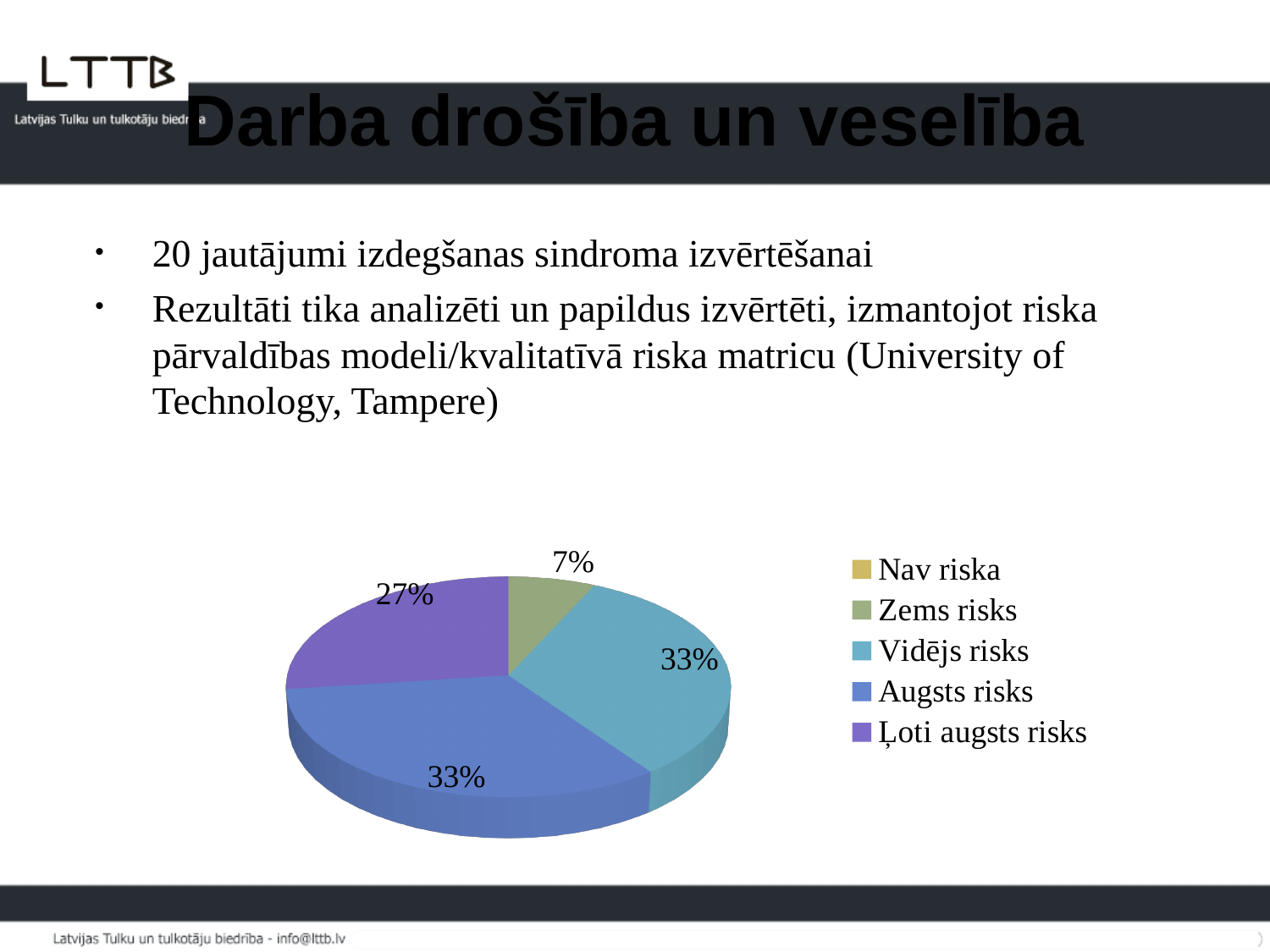
What is the difference in percentage points between the Augsts risks slice and the Ļoti augsts risks slice? 6% What kind of chart is shown on the slide? Pie chart Which slice is larger in the pie chart: Ļoti augsts risks or Zems risks? Ļoti augsts risks How many entries does the legend of the pie chart list? 5 What percentage does the pie chart show for Zems risks? 7% What percentage does the pie chart show for Ļoti augsts risks? 27% What percentage does the pie chart show for Vidējs risks? 33% What is the difference in percentage points between the Vidējs risks slice and the Zems risks slice? 26% How many percentage labels are shown on the pie chart? 4 Which slice is larger in the pie chart: Vidējs risks or Ļoti augsts risks? Vidējs risks What percentage does the pie chart show for Augsts risks? 33% What colour represents Ļoti augsts risks in the pie chart? Purple